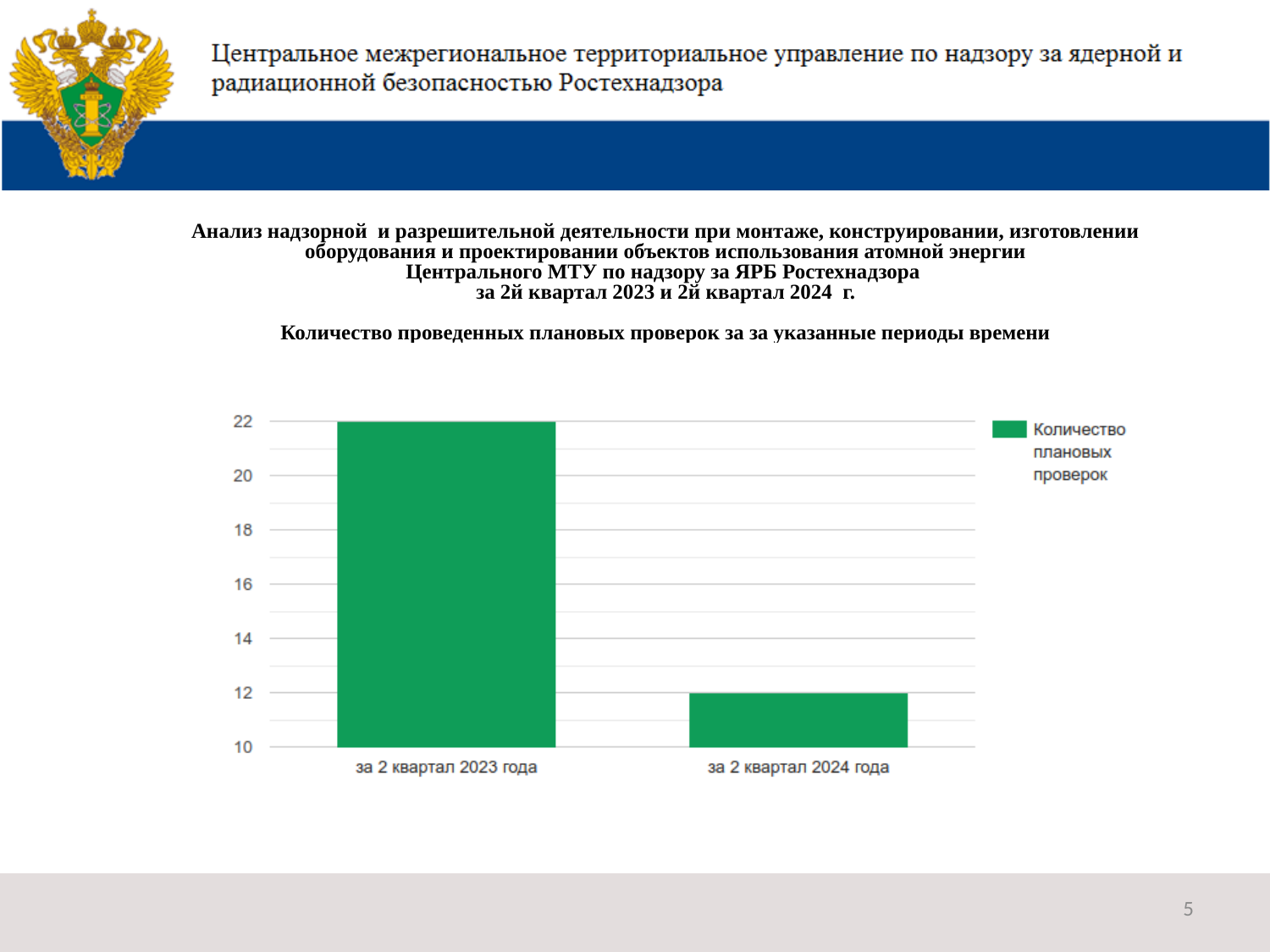
What is the legend entry for the series shown in the chart? Количество плановых проверок By how much does the number of planned inspections for 2 квартал 2023 exceed that for 2 квартал 2024? 10 Is the value for "за 2 квартал 2024 года" larger or smaller than the value for "за 2 квартал 2023 года"? smaller What is the number of planned inspections for "за 2 квартал 2023 года"? 22 Is the value for "за 2 квартал 2023 года" greater or less than 20? greater Which period has the higher number of planned inspections? за 2 квартал 2023 года How many series does the legend list? 1 What is the number of planned inspections for "за 2 квартал 2024 года"? 12 Which period has the lower number of planned inspections? за 2 квартал 2024 года How many categories (periods) are shown on the chart? 2 What kind of chart is shown on the slide? bar chart Is the value for "за 2 квартал 2024 года" greater or less than 14? less